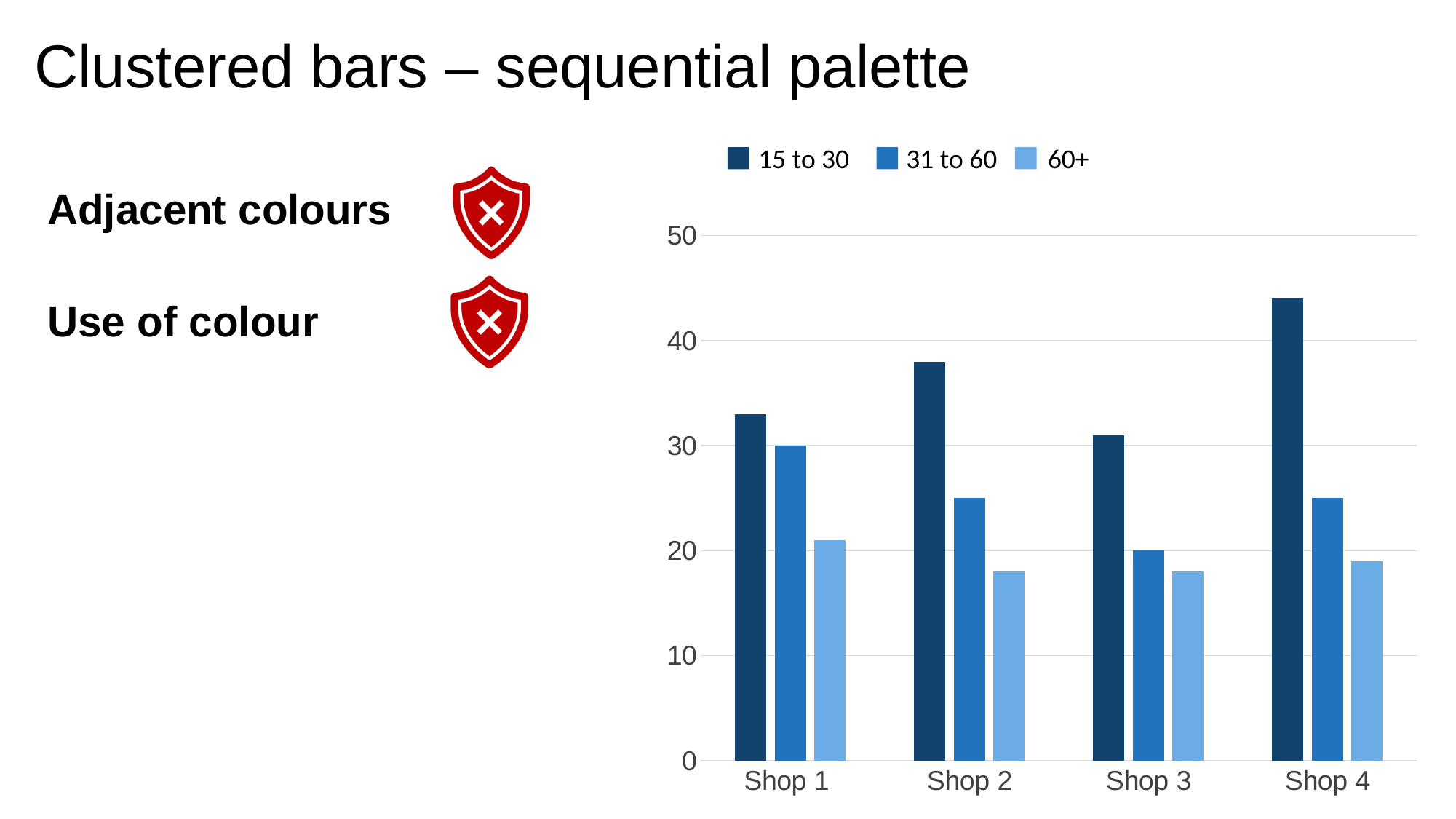
How many series does the legend list? 3 Is the value for 15 to 30 at Shop 2 greater or less than 40? less How many shops are shown on the x axis? 4 Which is larger: the 15 to 30 value at Shop 2 or at Shop 1? Shop 2 Which shop has the highest value for the 31 to 60 series? Shop 1 Is the value for 15 to 30 at Shop 4 greater or less than 40? greater Which shop has the lowest value for the 15 to 30 series? Shop 3 Which shop has the highest value for the 15 to 30 series? Shop 4 Is the value for 60+ at Shop 2 greater or less than 20? less What are the three series names listed in the legend? 15 to 30, 31 to 60, 60+ Which is larger at Shop 3: the 31 to 60 value or the 60+ value? 31 to 60 What kind of chart is shown on the slide? bar chart